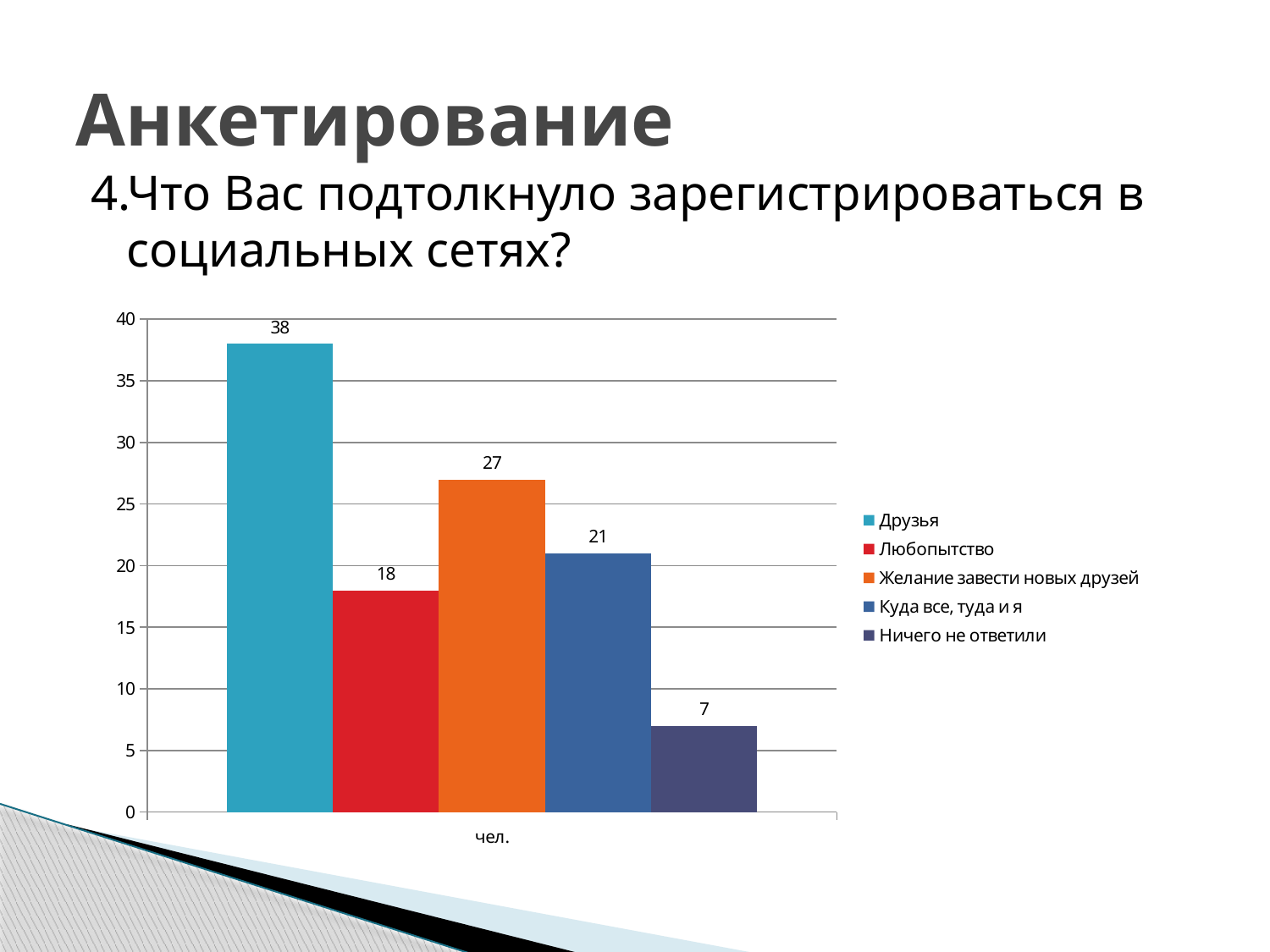
What is the value for Желание завести новых друзей? 27 Which series has the highest value? Друзья What is the difference between the values for Друзья and Любопытство? 20 What is the value for Ничего не ответили? 7 Which is larger, the value for Желание завести новых друзей or the value for Куда все, туда и я? Желание завести новых друзей What is the value for Друзья? 38 What is the label shown on the x axis of the chart? чел. How many series does the legend list? 5 Which series has the lowest value? Ничего не ответили What kind of chart is shown on the slide? bar chart What is the value for Куда все, туда и я? 21 What is the value for Любопытство? 18